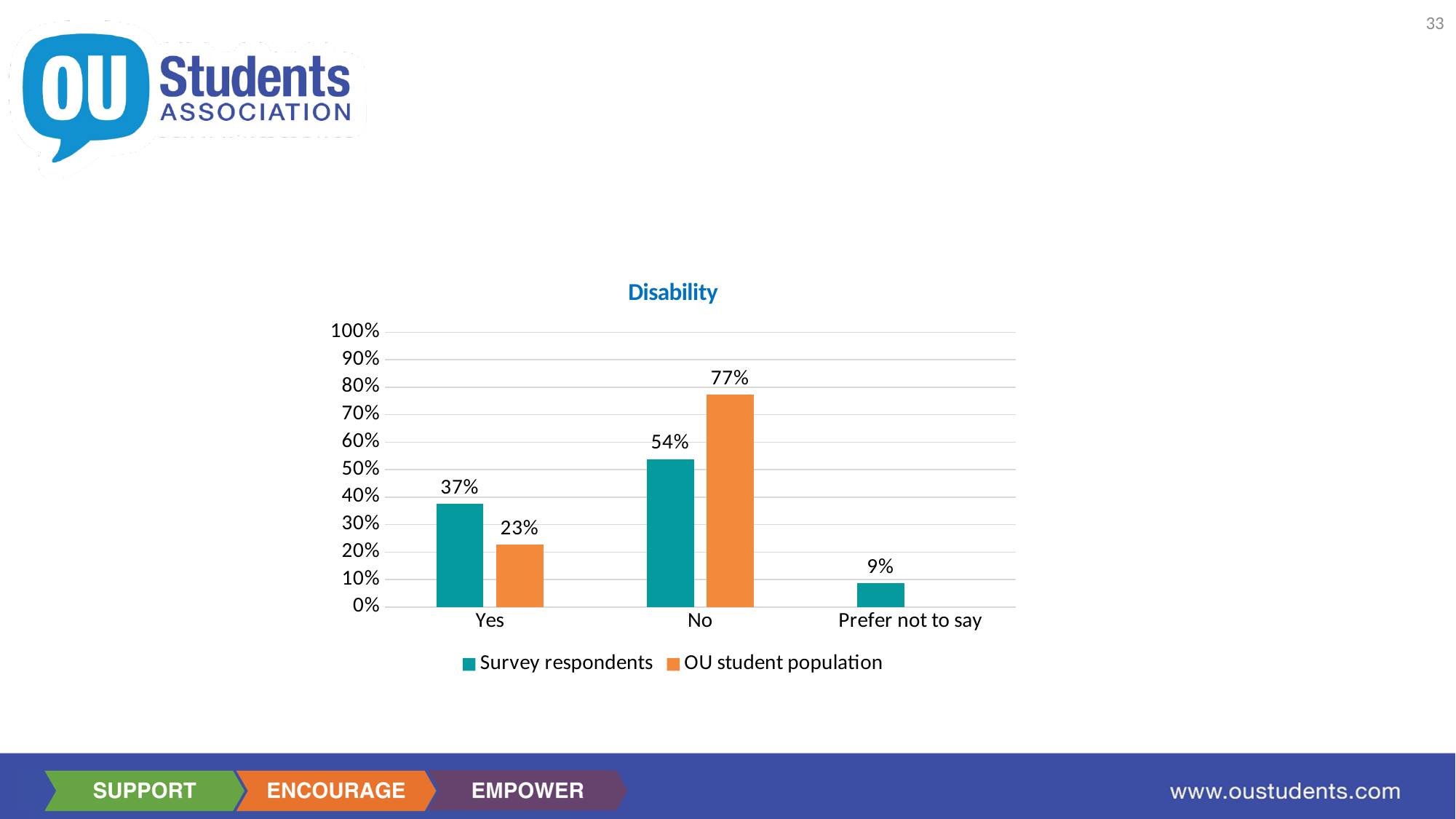
What is the title of the chart? Disability What is the value for Survey respondents in the Prefer not to say category? 9% What is the value for OU student population in the Yes category? 23% How many categories are shown on the x axis? 3 Which category has the lowest value for Survey respondents? Prefer not to say What is the value for OU student population in the No category? 77% What is the value for Survey respondents in the Yes category? 37% Which category has the highest value for Survey respondents? No What kind of chart is shown? Bar chart What is the difference between OU student population and Survey respondents in the No category? 23% In the Yes category, which is larger: Survey respondents or OU student population? Survey respondents How many series does the legend list? 2